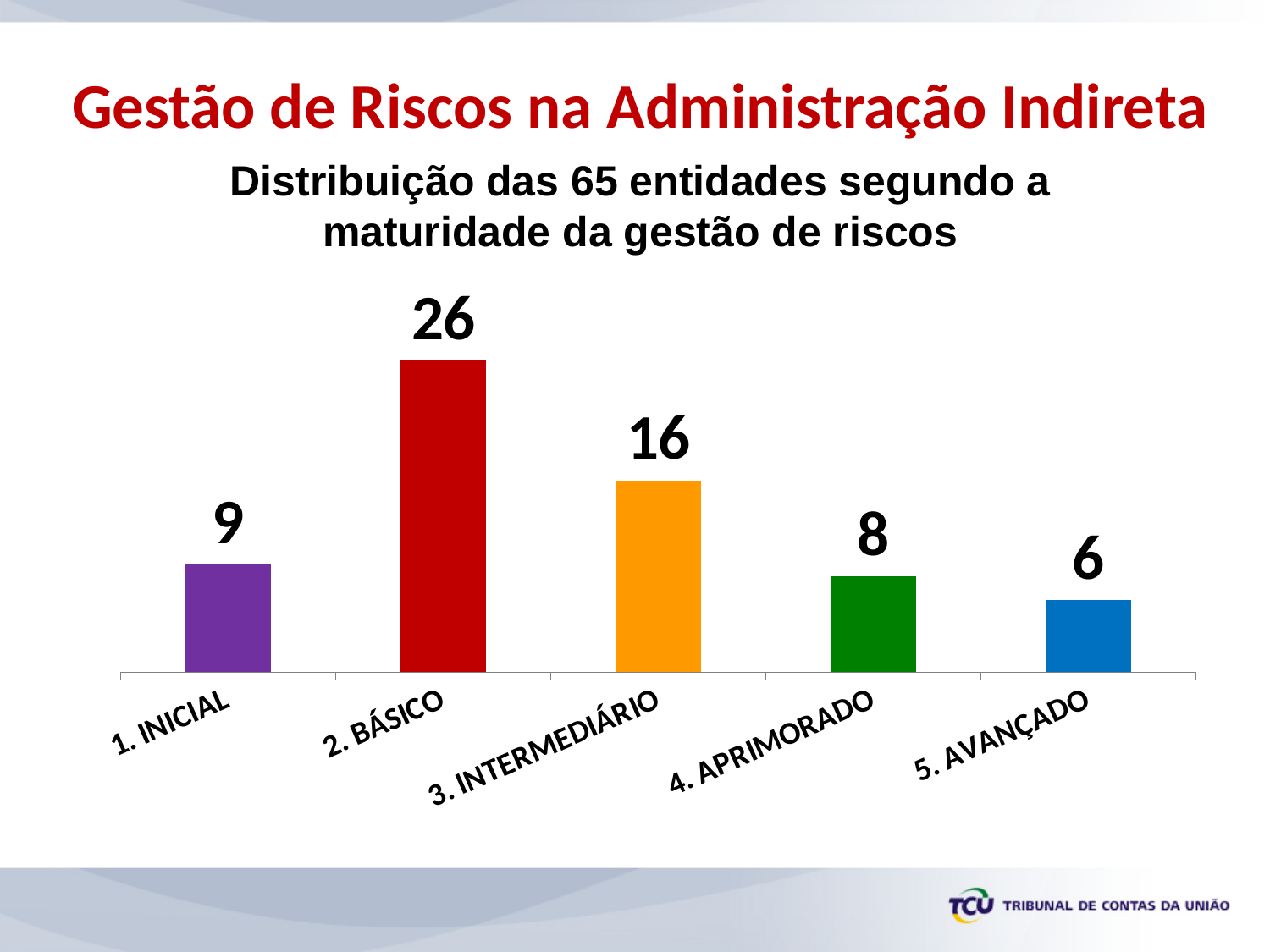
Which is larger, the value for 1. INICIAL or the value for 5. AVANÇADO? 1. INICIAL What is the total of all the values shown in the chart? 65 What is the value for 5. AVANÇADO? 6 Which category has the highest value? 2. BÁSICO What is the value for 3. INTERMEDIÁRIO? 16 What kind of chart is shown on the slide? Bar chart What is the value for 2. BÁSICO? 26 What colour is the bar for 4. APRIMORADO? Green What is the difference between the values for 2. BÁSICO and 3. INTERMEDIÁRIO? 10 How many categories are shown in the chart? 5 What is the difference between the values for 1. INICIAL and 4. APRIMORADO? 1 Which category has the lowest value? 5. AVANÇADO